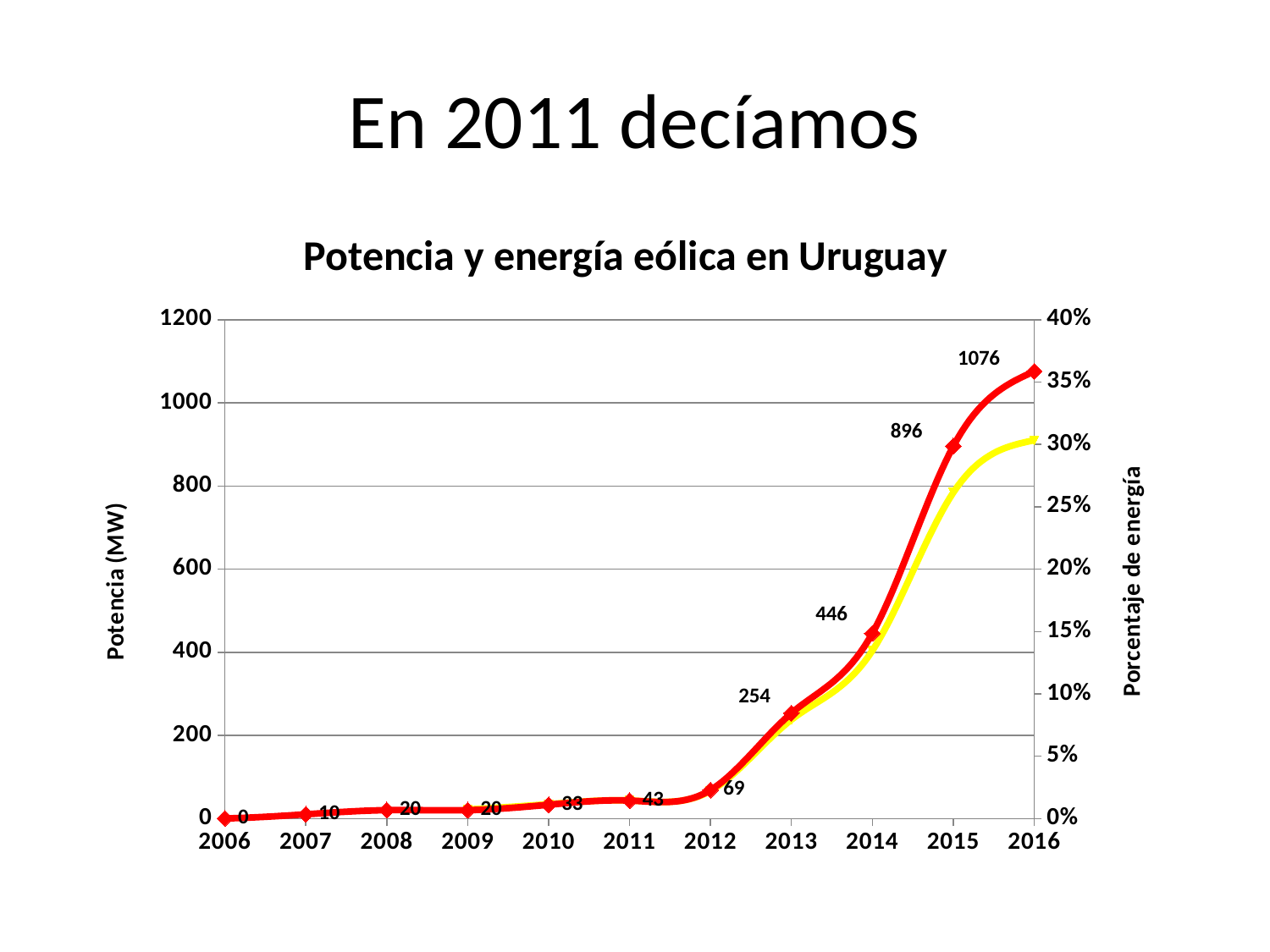
What is the title of the chart? Potencia y energía eólica en Uruguay What is the value of Potencia (MW) for 2011? 43 Which year has the lowest Potencia (MW) value? 2006 How many years are shown on the x axis? 11 Is the Porcentaje de energía value (yellow line) for 2016 greater or less than 25%? greater What is the value of Potencia (MW) for 2013? 254 Which year has a larger Potencia (MW) value, 2012 or 2013? 2013 What is the value of Potencia (MW) for 2016? 1076 What is the value of Potencia (MW) for 2007? 10 Which year has the highest Potencia (MW) value? 2016 What kind of chart is shown on the slide? Line chart What is the difference in Potencia (MW) between 2015 and 2014? 450